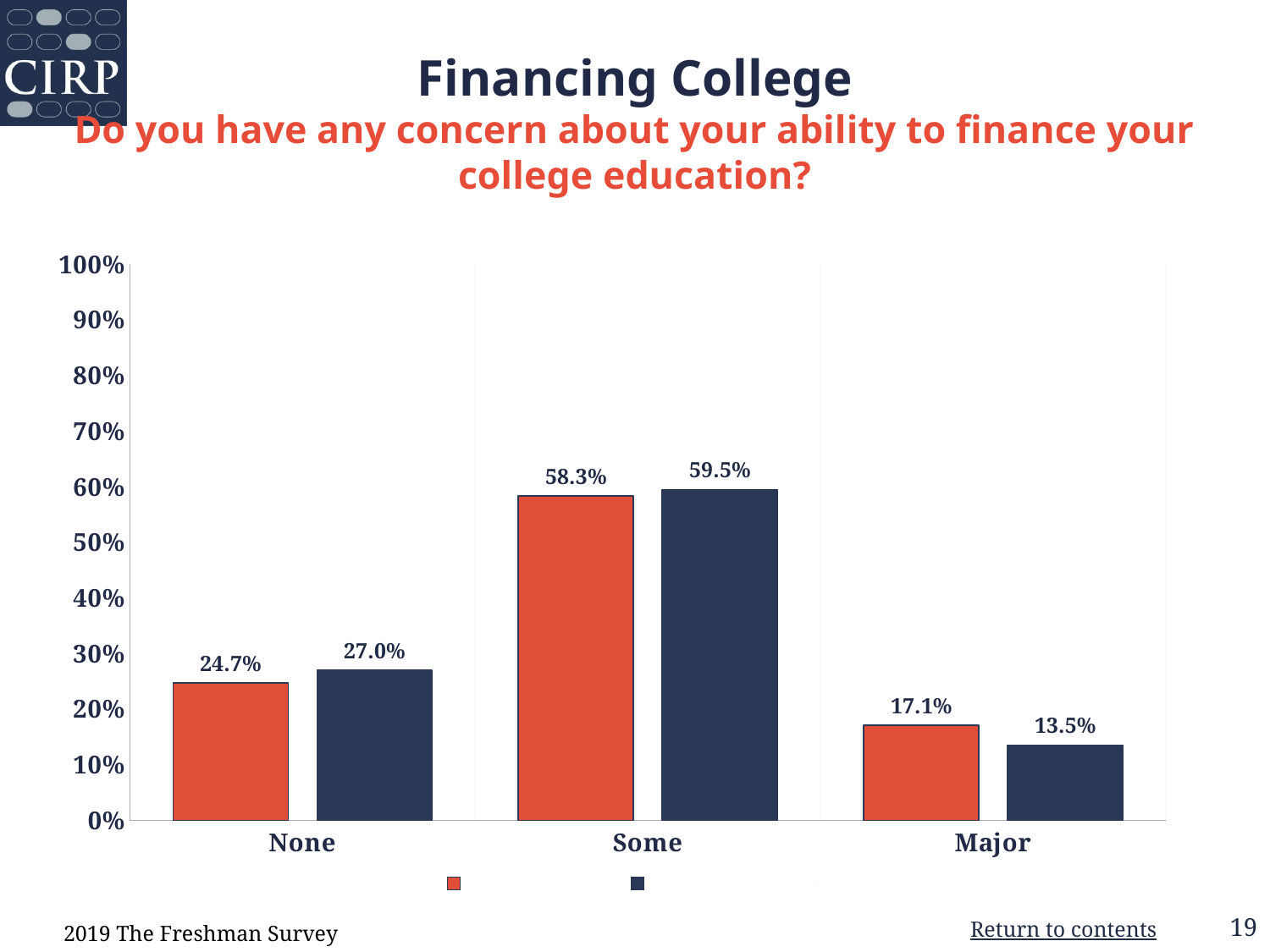
What is the value of the dark blue bar for the "None" category? 27.0% Which category has the lowest value for the orange bars? Major How many categories are shown on the x axis of the chart? 3 What is the value of the orange bar for the "Some" category? 58.3% What is the value of the orange bar for the "Major" category? 17.1% What kind of chart is shown on the slide? bar chart Which category has the highest value for the dark blue bars? Some What is the difference between the orange bar and the dark blue bar for the "Major" category? 3.6% What is the value of the dark blue bar for the "Major" category? 13.5% For the "Major" category, which bar is larger, the orange bar or the dark blue bar? the orange bar Is the value of the dark blue bar for "Some" greater or less than 50%? greater What is the difference between the dark blue bar and the orange bar for the "None" category? 2.3%